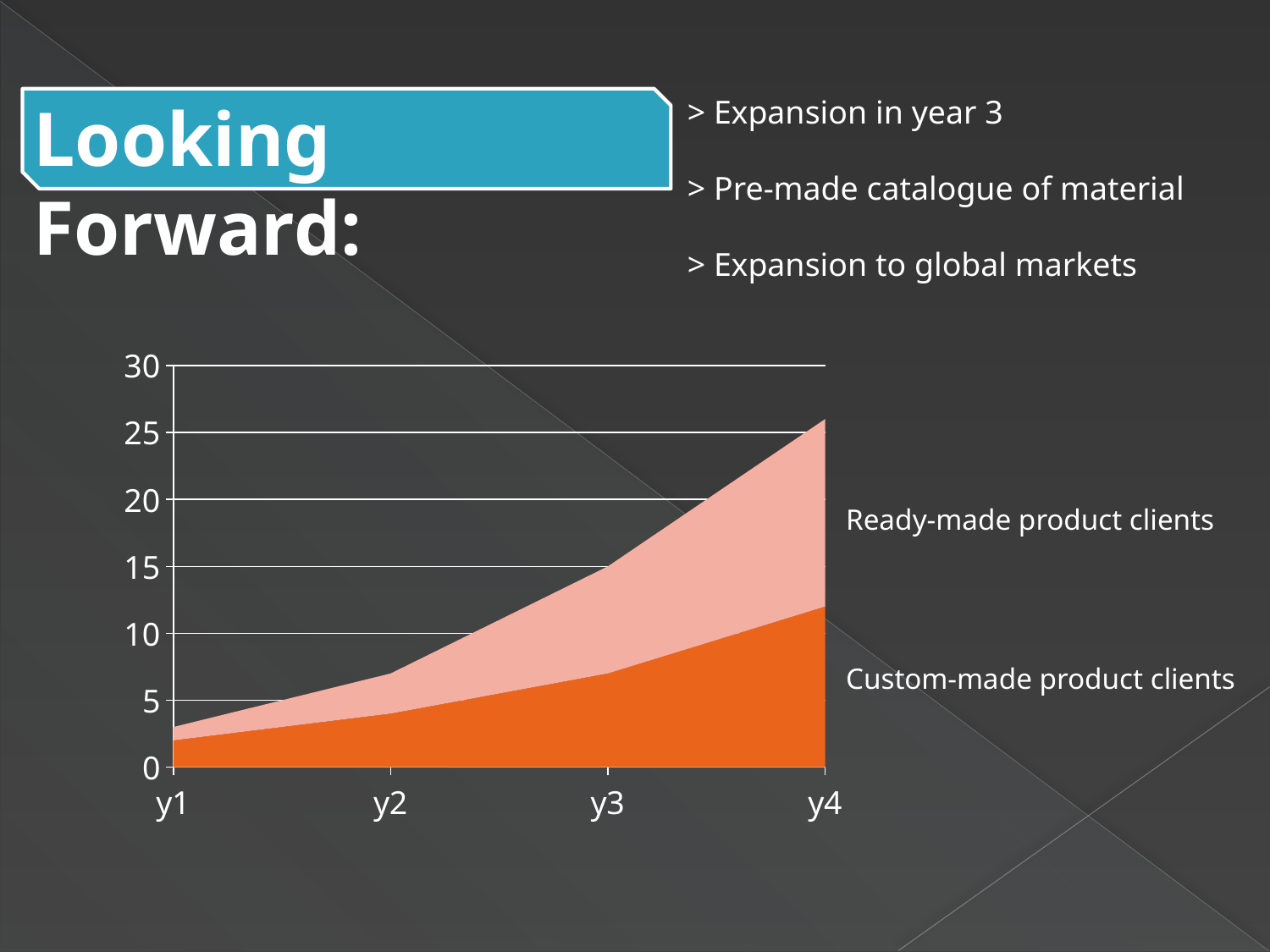
What kind of chart is shown on the slide? Area chart Is the stacked total of both series in y2 greater or less than 10? less How many categories are shown on the x axis of the chart? 4 In which year is the value for Custom-made product clients lowest? y1 Is the value for Custom-made product clients in y4 greater or less than 10? greater How many series does the chart's legend list? 2 Which is larger: the value for Custom-made product clients in y4 or in y2? y4 Is the stacked total of both series in y4 greater or less than 25? greater In which year is the value for Custom-made product clients highest? y4 Which series is shown in the darker orange colour at the bottom of the chart? Custom-made product clients Do the values for Custom-made product clients rise or fall from y1 to y4? Rise